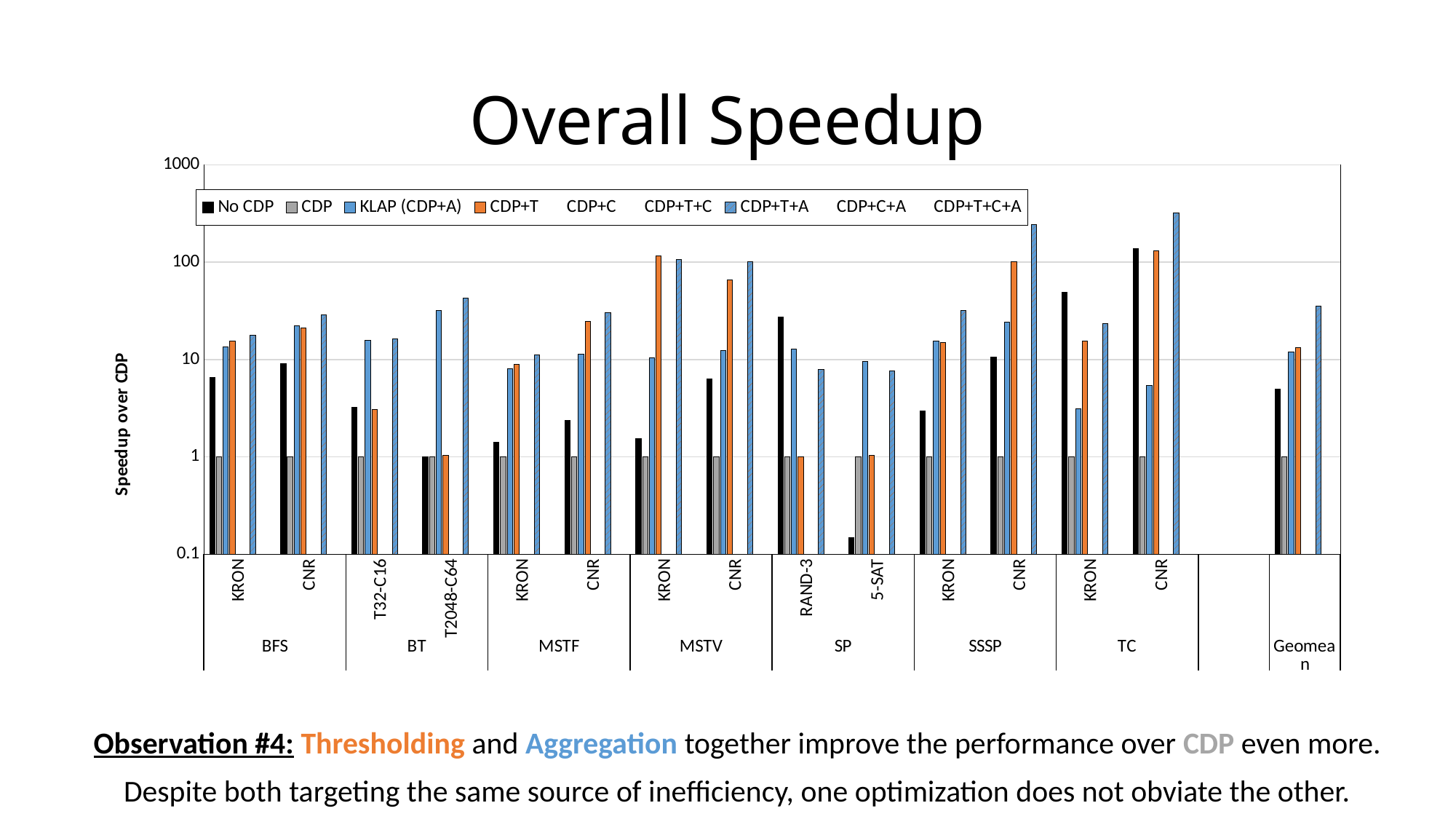
How many series does the legend list? 9 What kind of chart is shown on the slide? bar chart Is the CDP+T+A value for Geomean greater or less than 10? greater How many benchmark groups (including Geomean) are shown along the x axis? 8 What is the title of the chart? Overall Speedup What is the label of the vertical axis? Speedup over CDP For TC CNR, which is larger: the No CDP value or the KLAP (CDP+A) value? No CDP Is the CDP+T value for MSTV KRON greater or less than 100? greater Is the No CDP value for SP 5-SAT greater or less than 1? less Which benchmark and series has the highest bar in the chart? CDP+T+A for TC CNR What is the value of the CDP bar for BFS KRON? 1